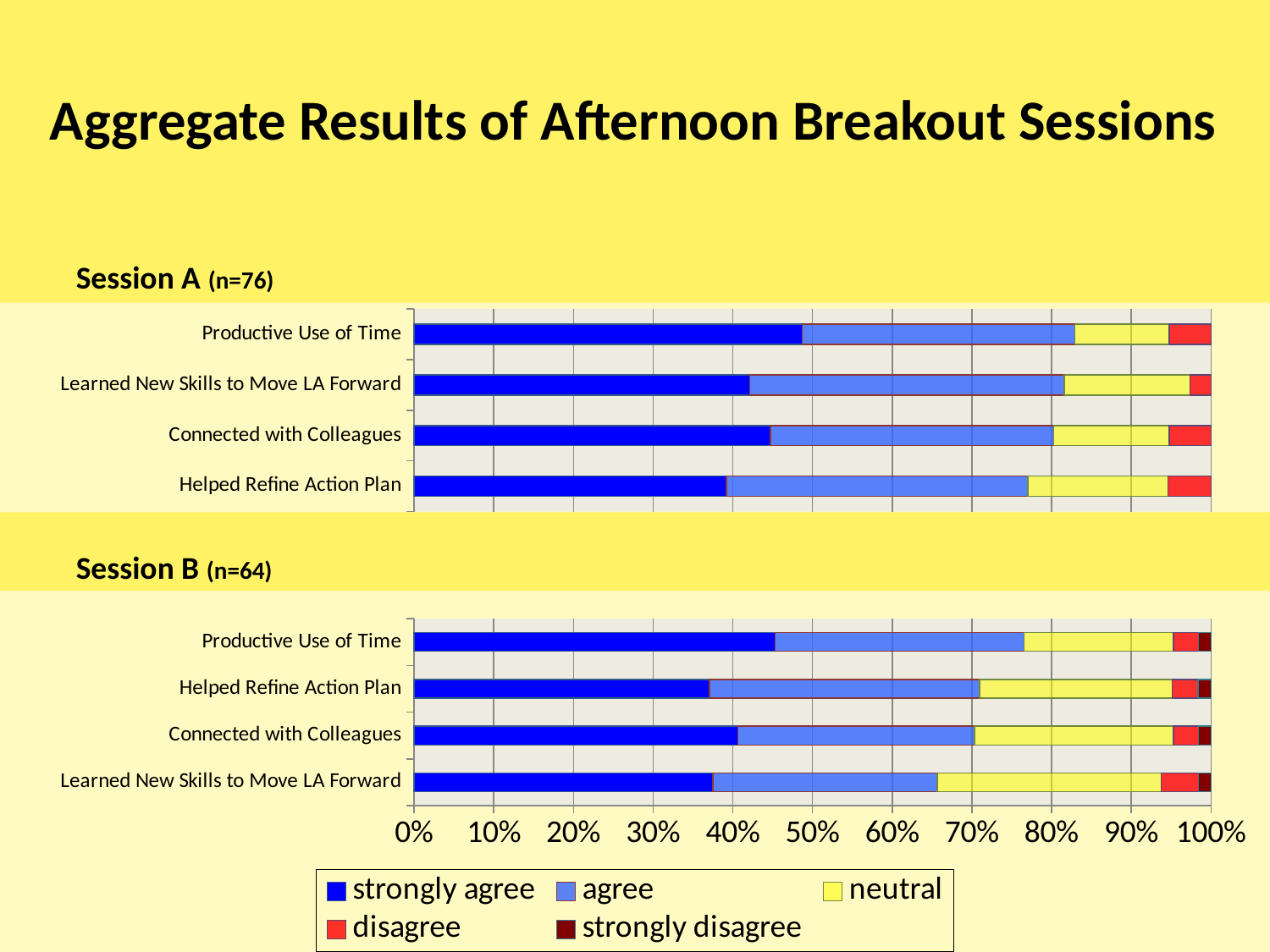
In the Session A (n=76) chart, which category has the largest strongly agree segment? Productive Use of Time In the Session B (n=64) chart, is the strongly agree value for Helped Refine Action Plan greater or less than 50%? less In the Session A (n=76) chart, is the strongly agree value for Productive Use of Time greater or less than 40%? greater Which legend entry is shown in dark red? strongly disagree In the Session B (n=64) chart, which category has the largest strongly agree segment? Productive Use of Time In the Session B (n=64) chart, which has the larger strongly agree segment, Productive Use of Time or Helped Refine Action Plan? Productive Use of Time In the Session A (n=76) chart, which has the larger strongly agree segment, Productive Use of Time or Helped Refine Action Plan? Productive Use of Time What kind of chart is used for Session A (n=76)? bar chart How many categories are plotted in the Session B (n=64) chart? 4 How many series does the legend list? 5 What is the sample size shown for Session B? n=64 In the Session A (n=76) chart, is the strongly agree value for Helped Refine Action Plan greater or less than 30%? greater